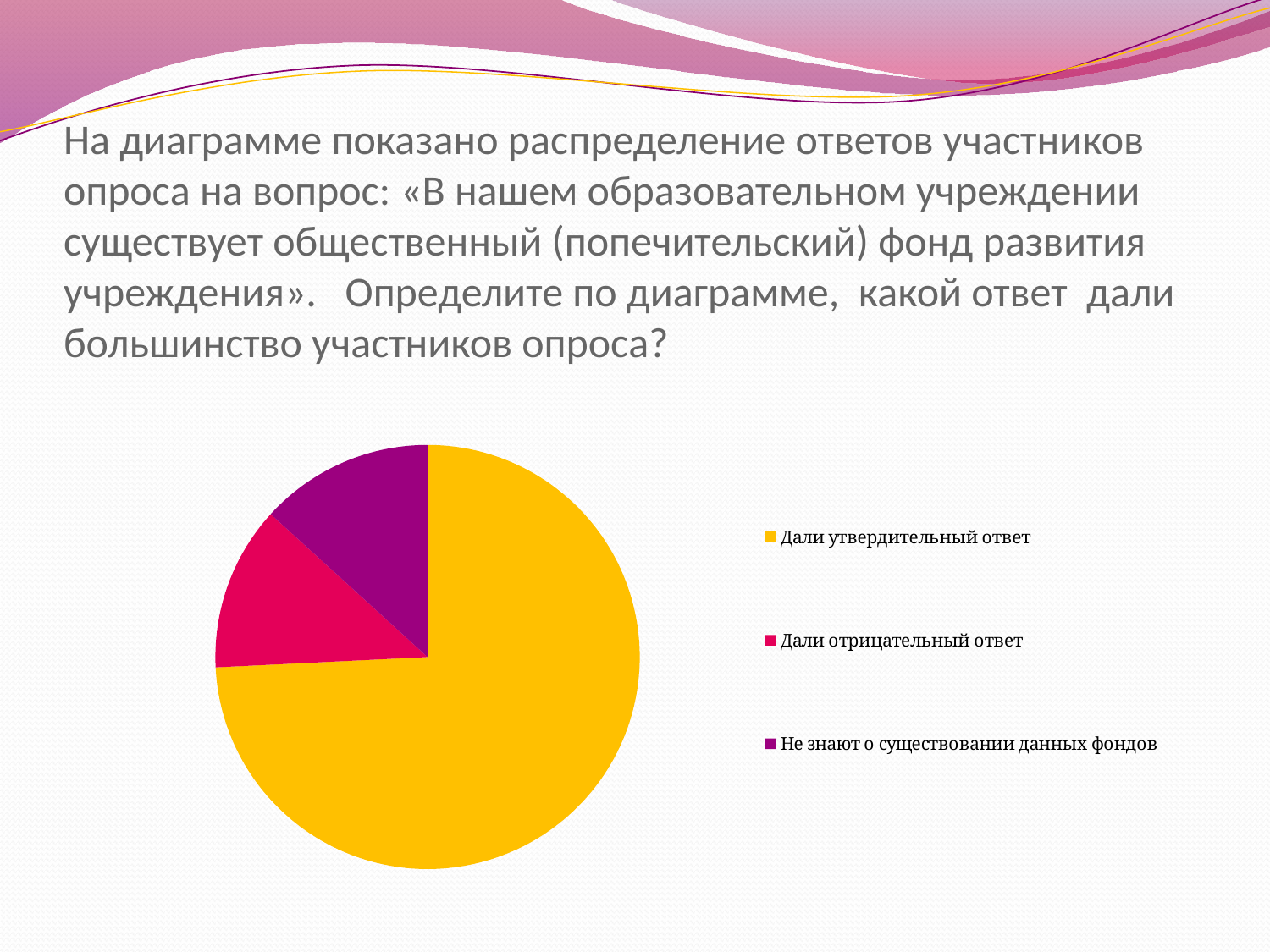
How many slices does the pie chart have? 3 Which slice is larger: "Дали утвердительный ответ" or "Дали отрицательный ответ"? Дали утвердительный ответ What kind of chart is shown on the slide? pie chart What colour is the slice for "Дали утвердительный ответ"? yellow Which legend entry is shown in purple? Не знают о существовании данных фондов Which category has the largest slice in the pie chart? Дали утвердительный ответ How many entries does the legend of the pie chart list? 3 Does the slice "Дали утвердительный ответ" take up more or less than half of the pie? more Which slice is larger: "Дали утвердительный ответ" or "Не знают о существовании данных фондов"? Дали утвердительный ответ